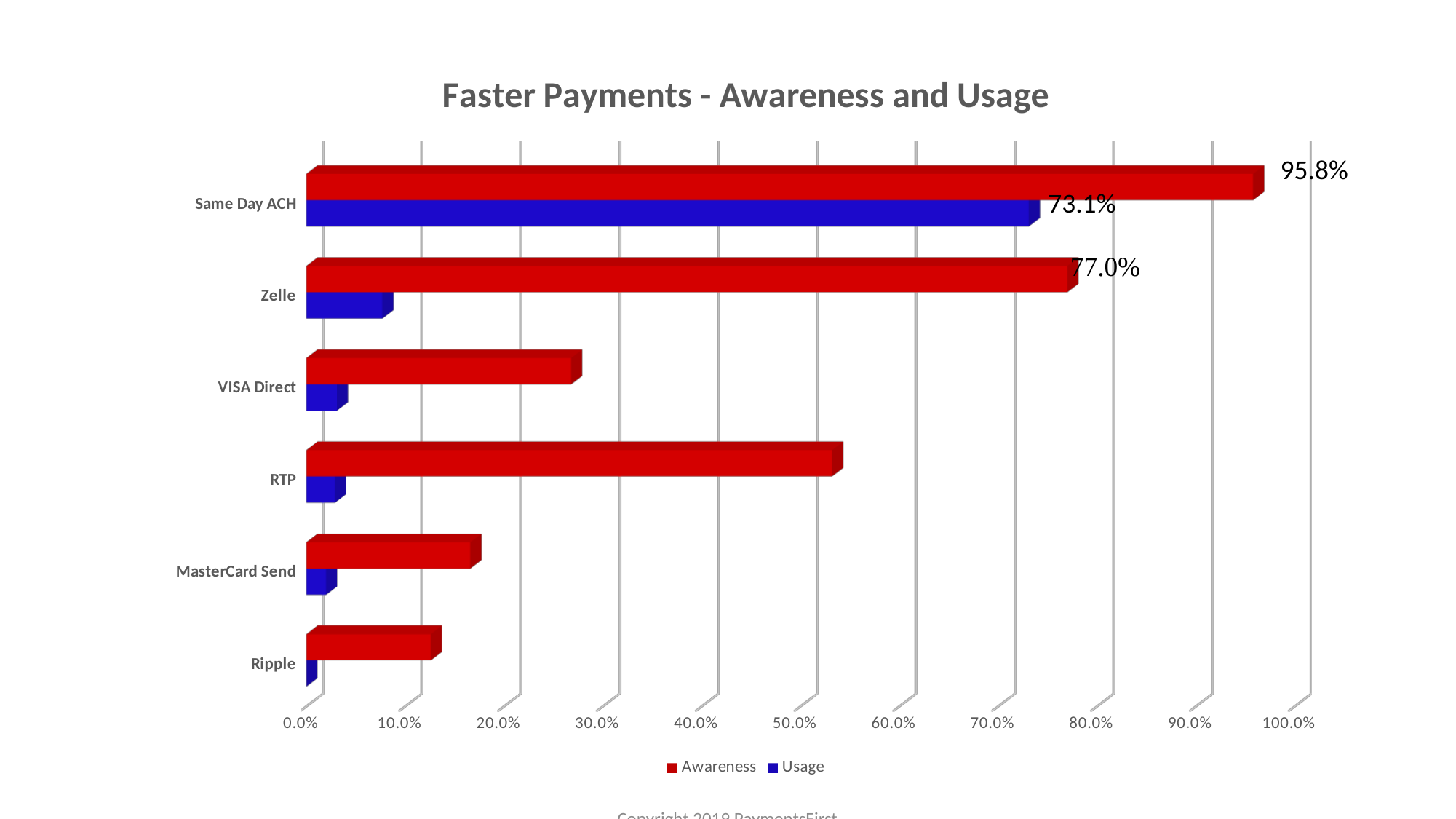
What is the Awareness value for Same Day ACH? 95.8% Which is larger: the Awareness value for RTP or the Awareness value for VISA Direct? RTP What is the Awareness value for Zelle? 77.0% Which category has the lowest Awareness value? Ripple How many categories are shown on the chart? 6 What kind of chart is shown on the slide? Bar chart Is the Awareness value for RTP greater or less than 50.0%? greater What is the Usage value for Same Day ACH? 73.1% Which category has the highest Awareness value? Same Day ACH Is the Awareness value for MasterCard Send greater or less than 20.0%? less What is the difference between the Awareness and Usage values for Same Day ACH? 22.7 percentage points How many series does the legend list? 2